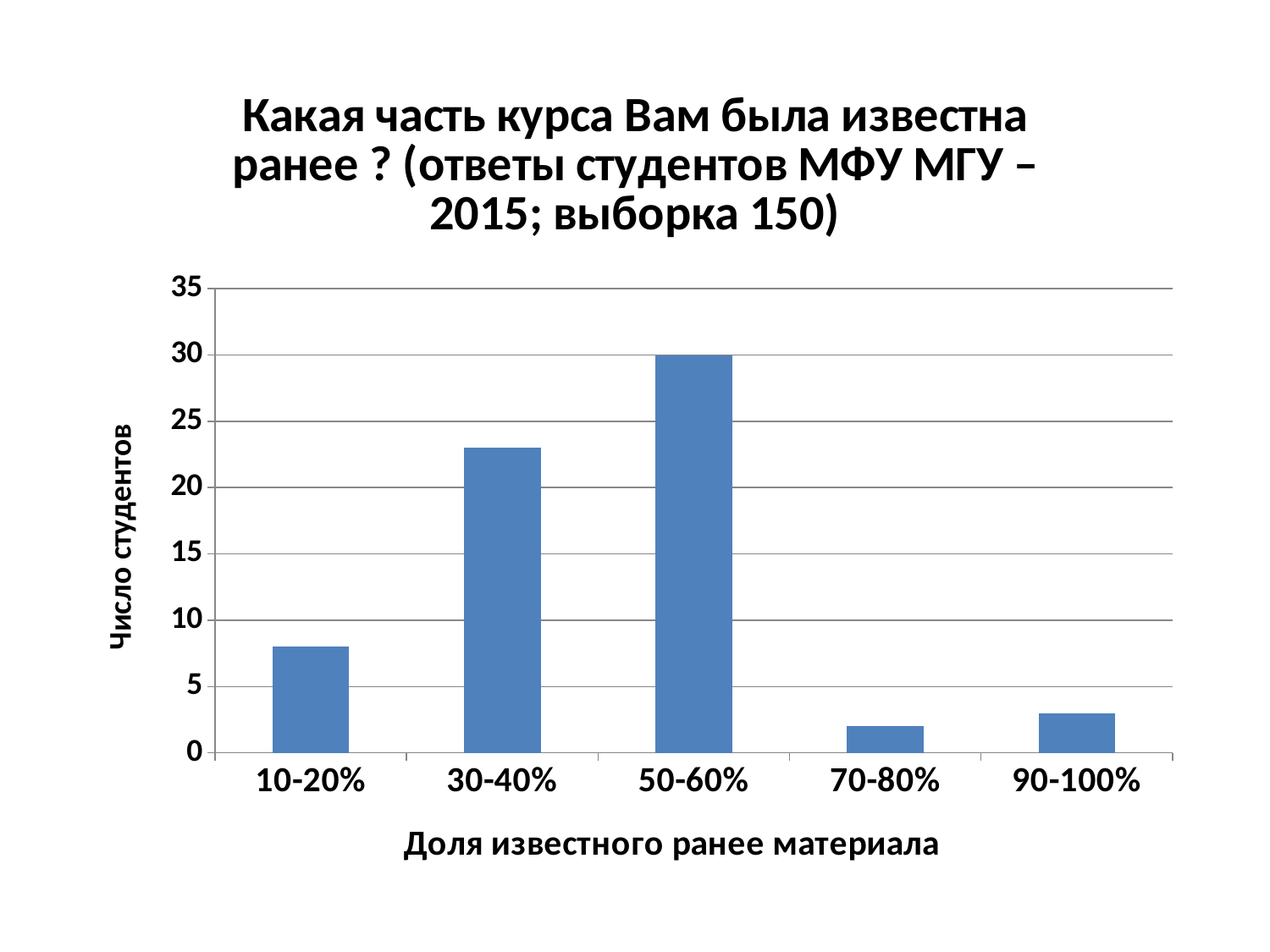
What kind of chart is shown on the slide? bar chart How many categories are shown on the x axis? 5 Is the value for 30-40% greater or less than 20? greater Which category has the highest number of students? 50-60% Is the value for 10-20% greater or less than 10? less Which is larger, the value for 10-20% or the value for 30-40%? 30-40% What is the value for the 50-60% category? 30 What is the title of the y axis? Число студентов Is the value for 90-100% greater or less than 5? less Which category has the lowest number of students? 70-80%